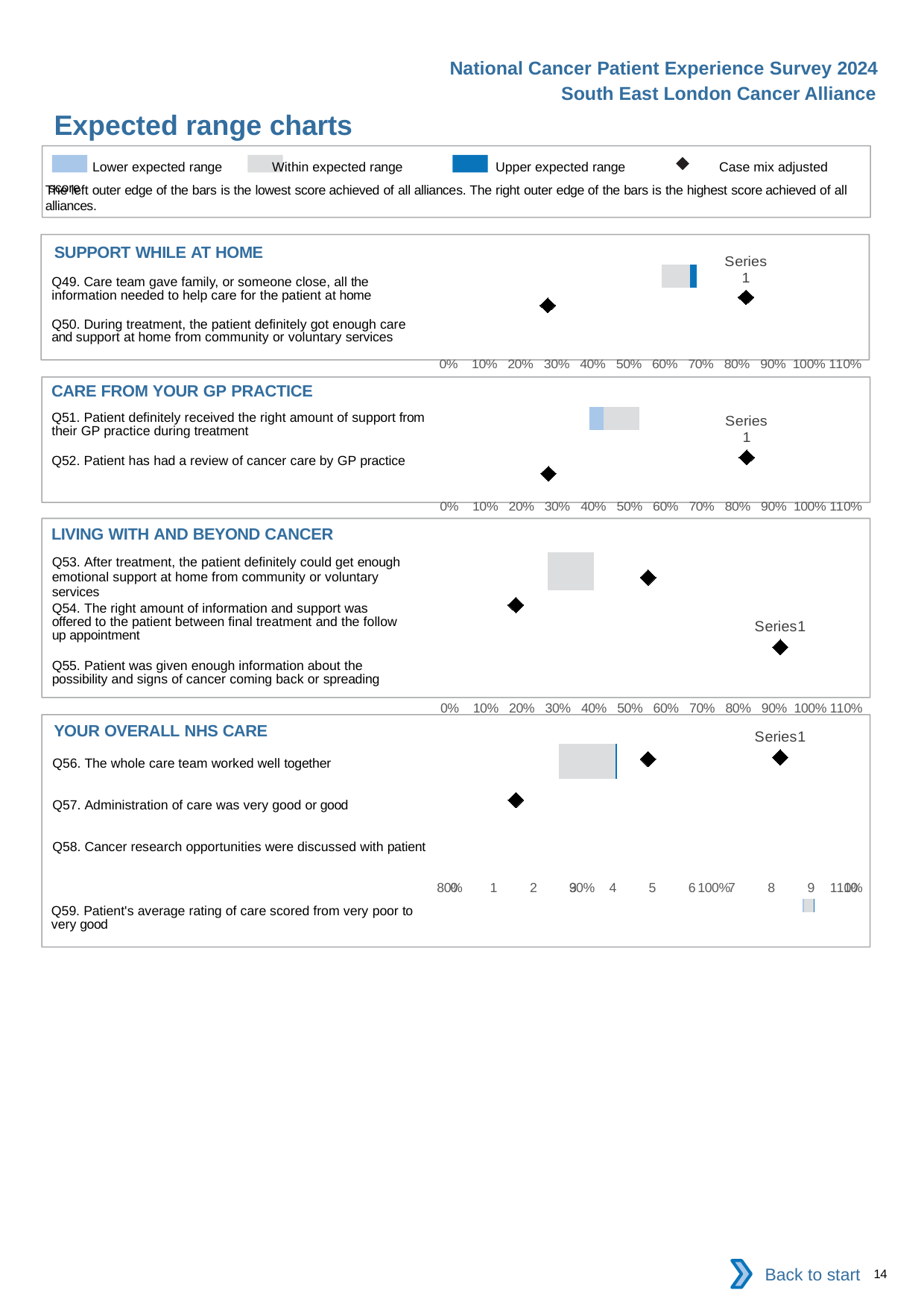
How many questions are listed in the SUPPORT WHILE AT HOME chart? 2 In the LIVING WITH AND BEYOND CANCER chart, is the expected range bar for Q53 greater or less than 50%? less How many questions are listed in the LIVING WITH AND BEYOND CANCER chart? 3 In the CARE FROM YOUR GP PRACTICE chart, is the expected range bar for Q51 greater or less than 70%? less How many questions are listed in the CARE FROM YOUR GP PRACTICE chart? 2 What is the title of the slide's set of charts? Expected range charts What is the highest percentage tick shown on the x axis of the SUPPORT WHILE AT HOME chart? 110% How many entries does the legend at the top of the slide list? 4 According to the legend, what does the diamond marker represent? Case mix adjusted score What kind of chart is used in the SUPPORT WHILE AT HOME section? Bar chart In the SUPPORT WHILE AT HOME chart, is the expected range bar for Q49 greater or less than 50%? greater